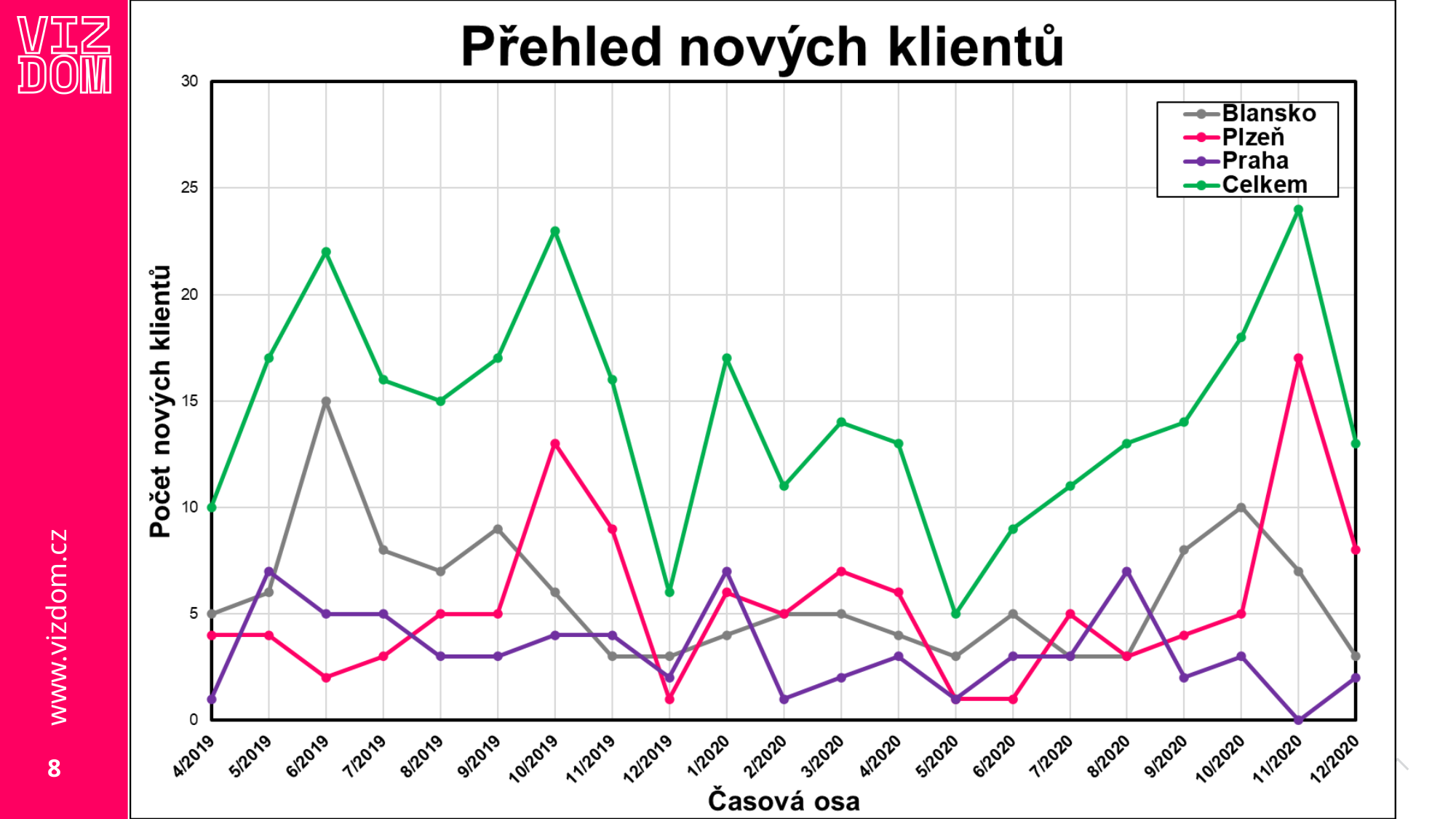
What is the value for Praha in 11/2020? 0 Does the Celkem line rise or fall from 5/2020 to 11/2020? rise Is the value for Celkem in 10/2019 greater or less than 20? greater What is the value for Celkem in 4/2019? 10 How many time points are plotted along the x axis? 21 In which month does Blansko reach its highest value? 6/2019 What is the value for Blansko in 10/2020? 10 How many series does the legend list? 4 In which month does Plzeň reach its highest value? 11/2020 What is the value for Blansko in 6/2019? 15 What type of chart is shown on the slide? line chart Is the value for Celkem in 12/2019 greater or less than 10? less